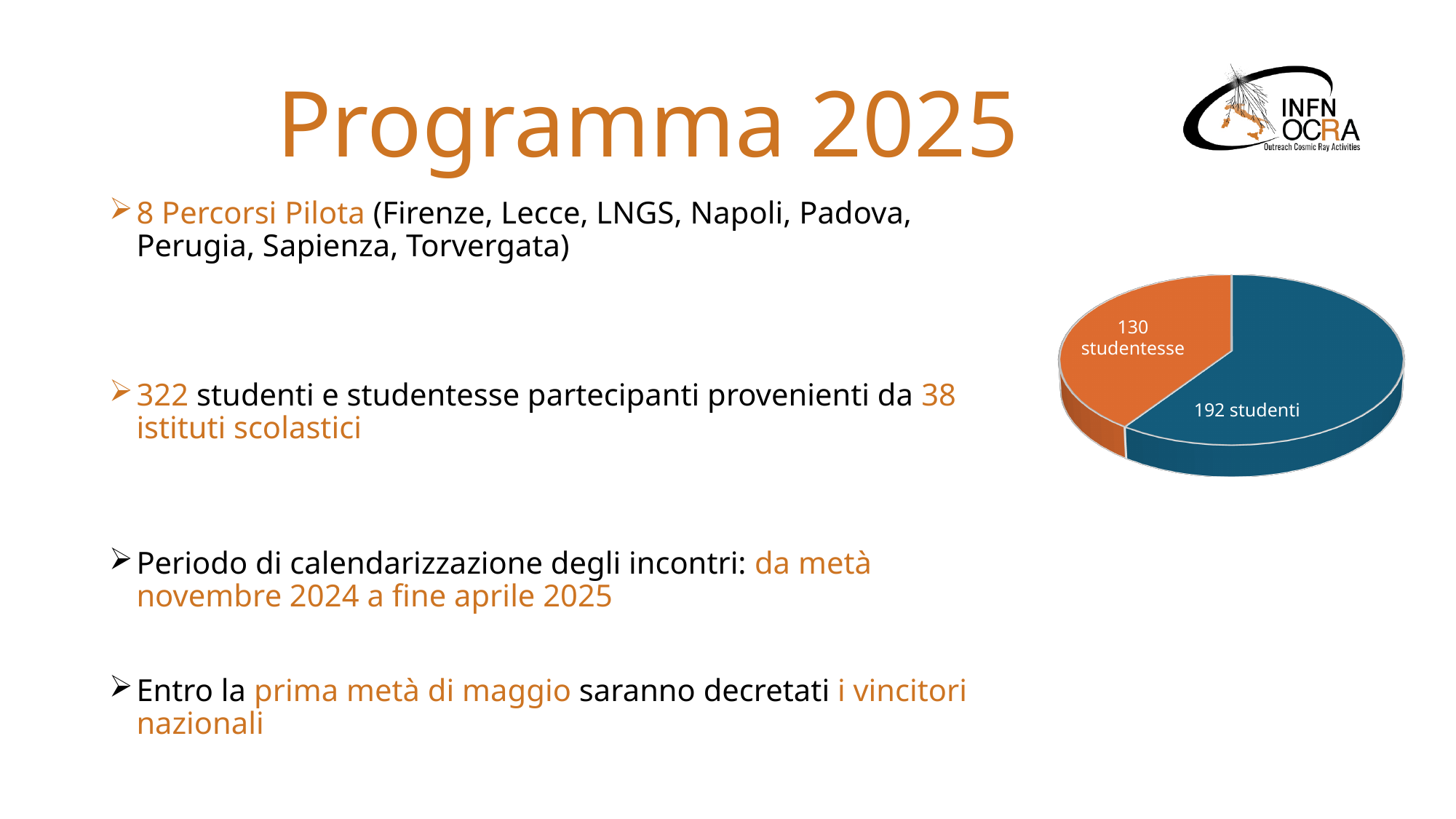
Which slice of the pie chart is the smallest? 130 studentesse What is the total of the two slices in the pie chart? 322 What colour is the studentesse slice in the pie chart? orange What colour is the studenti slice in the pie chart? blue How many studentesse are shown in the pie chart? 130 Which slice of the pie chart is the largest? 192 studenti How many slices does the pie chart have? 2 What is the difference between the number of studenti and the number of studentesse in the pie chart? 62 What kind of chart is shown on the slide? pie chart What share of the pie chart do the 192 studenti represent? 59.6% Which is larger in the pie chart, the number of studenti or the number of studentesse? studenti How many studenti are shown in the pie chart? 192